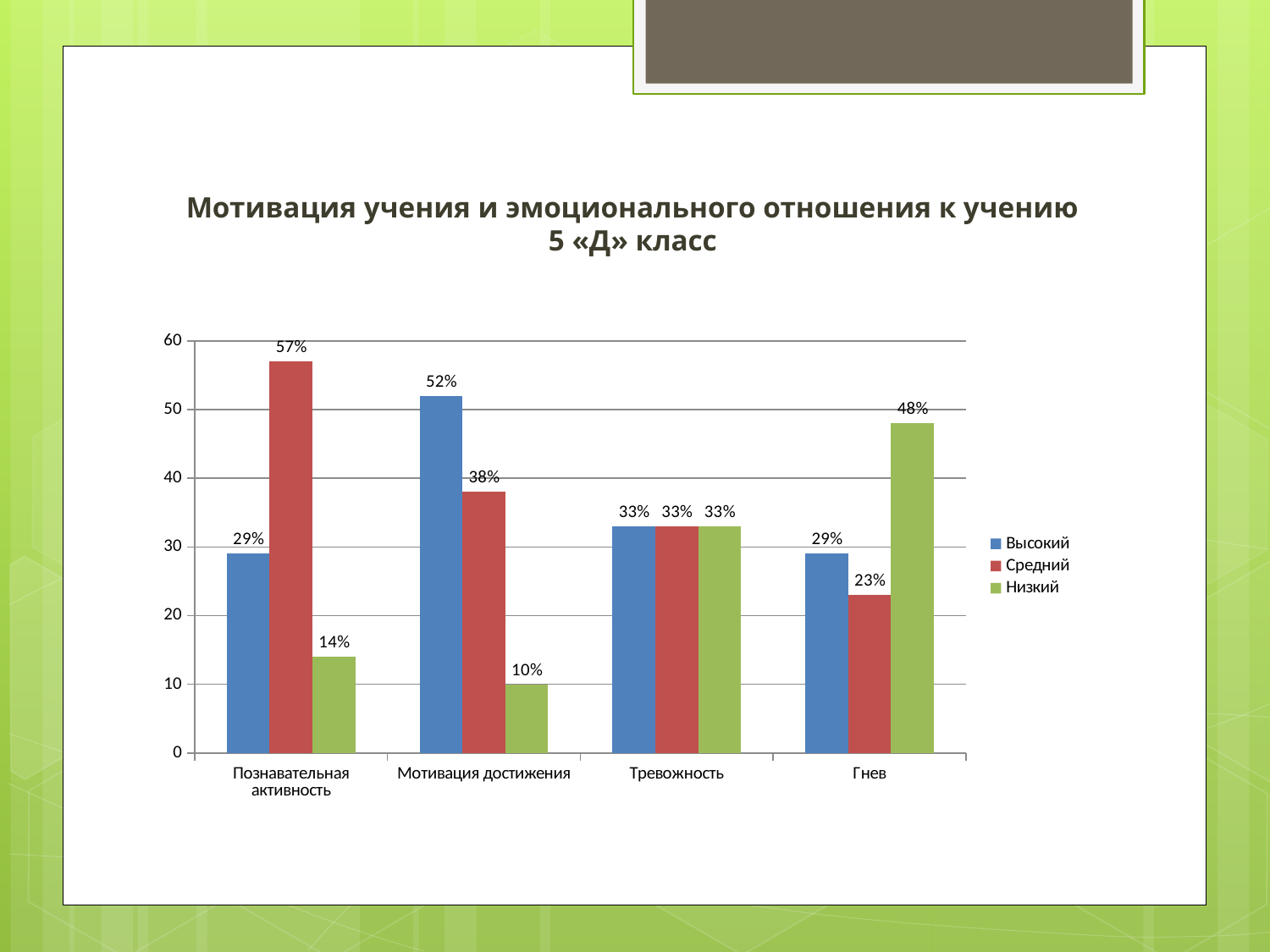
What is the title of the chart? Мотивация учения и эмоционального отношения к учению 5 «Д» класс What is the value of the Средний series for Мотивация достижения? 38% Which is larger for Гнев: the Высокий value or the Средний value? Высокий What is the value of the Низкий series for Гнев? 48% Which series is shown in red in the legend? Средний How many categories are shown on the x axis? 4 What is the value of the Высокий series for Познавательная активность? 29% Which category has the highest value for the Средний series? Познавательная активность Which category has the lowest value for the Низкий series? Мотивация достижения What kind of chart is shown on the slide? Bar chart How many series does the legend list? 3 What is the difference between the Средний and Низкий values for Познавательная активность? 43%